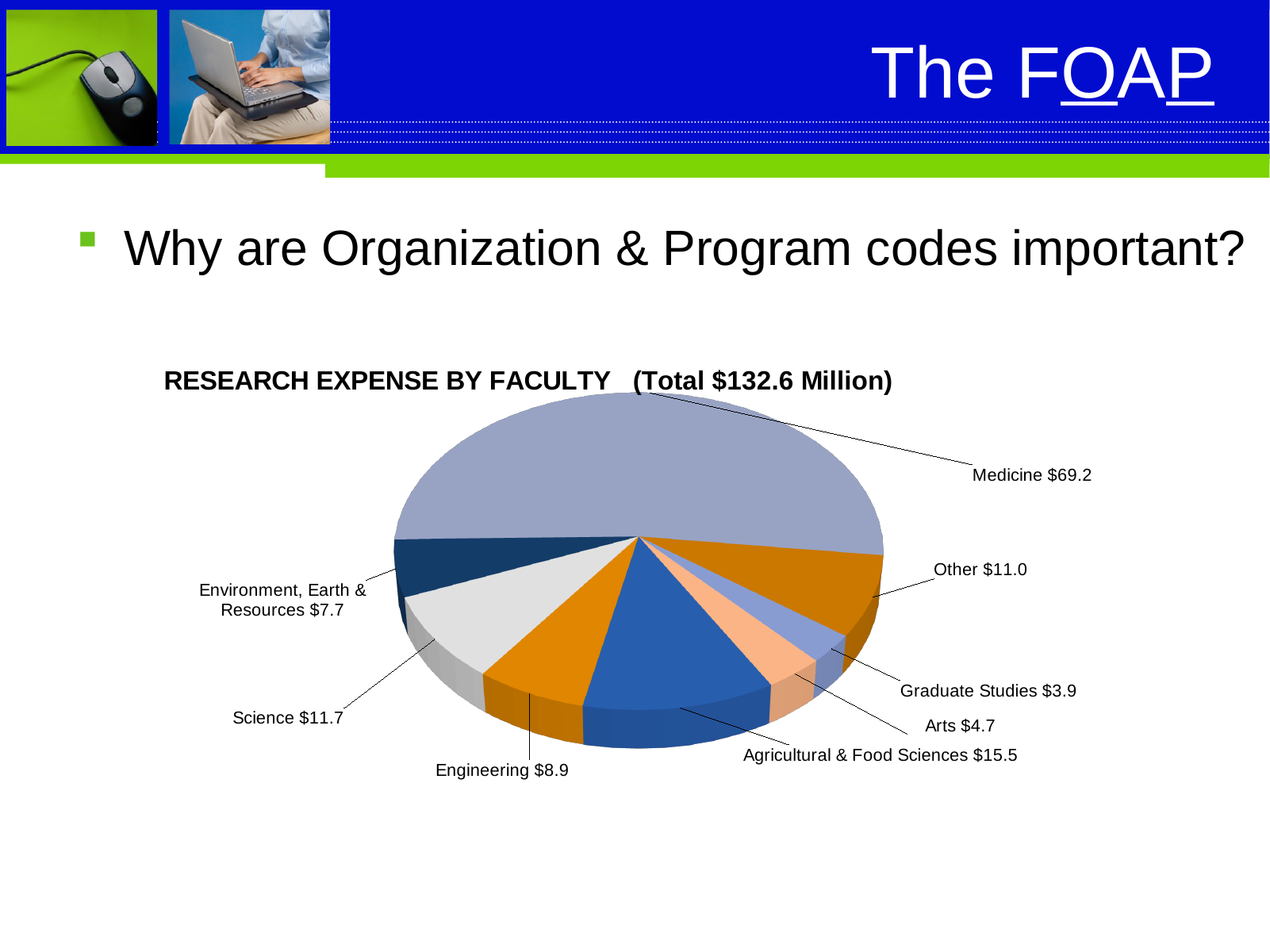
What is the research expense for Medicine? $69.2 Which faculty has the smallest research expense? Graduate Studies Which faculty has the largest research expense? Medicine What is the research expense for Agricultural & Food Sciences? $15.5 What is the difference between the research expense for Agricultural & Food Sciences and for Engineering? $6.6 What kind of chart is shown on the slide? pie chart Which has the larger research expense, Science or Other? Science What is the difference between the research expense for Medicine and for Other? $58.2 What is the research expense for Graduate Studies? $3.9 What is the research expense for Environment, Earth & Resources? $7.7 How many faculty categories are shown in the pie chart? 8 What total research expense is stated in the chart title? $132.6 Million